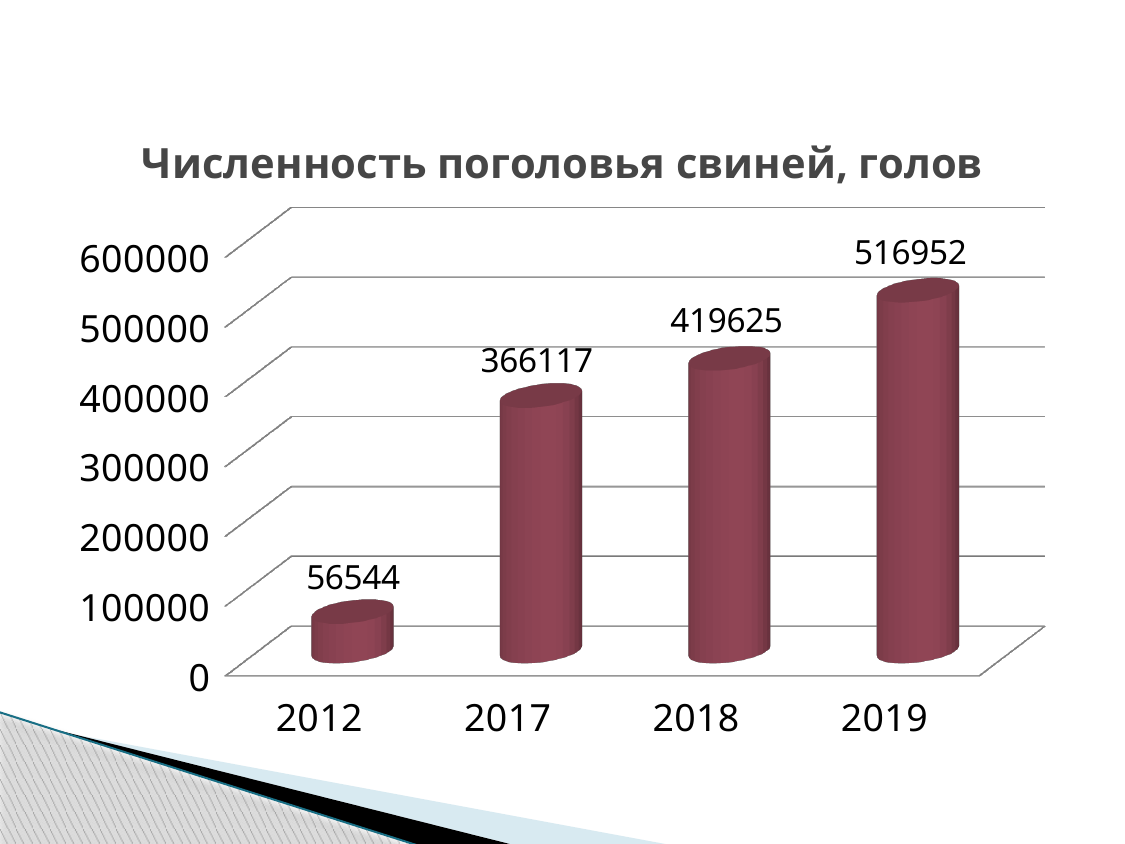
Which year has the lowest value? 2012 What kind of chart is this? bar chart Which year has the highest value? 2019 What is the value for 2018? 419625 Which is larger, the value for 2017 or the value for 2018? 2018 What is the difference between the values for 2017 and 2012? 309573 What is the value for 2012? 56544 What is the value for 2019? 516952 How many years are shown on the x axis? 4 Do the values rise or fall from 2012 to 2019? rise What is the value for 2017? 366117 What is the difference between the values for 2019 and 2018? 97327